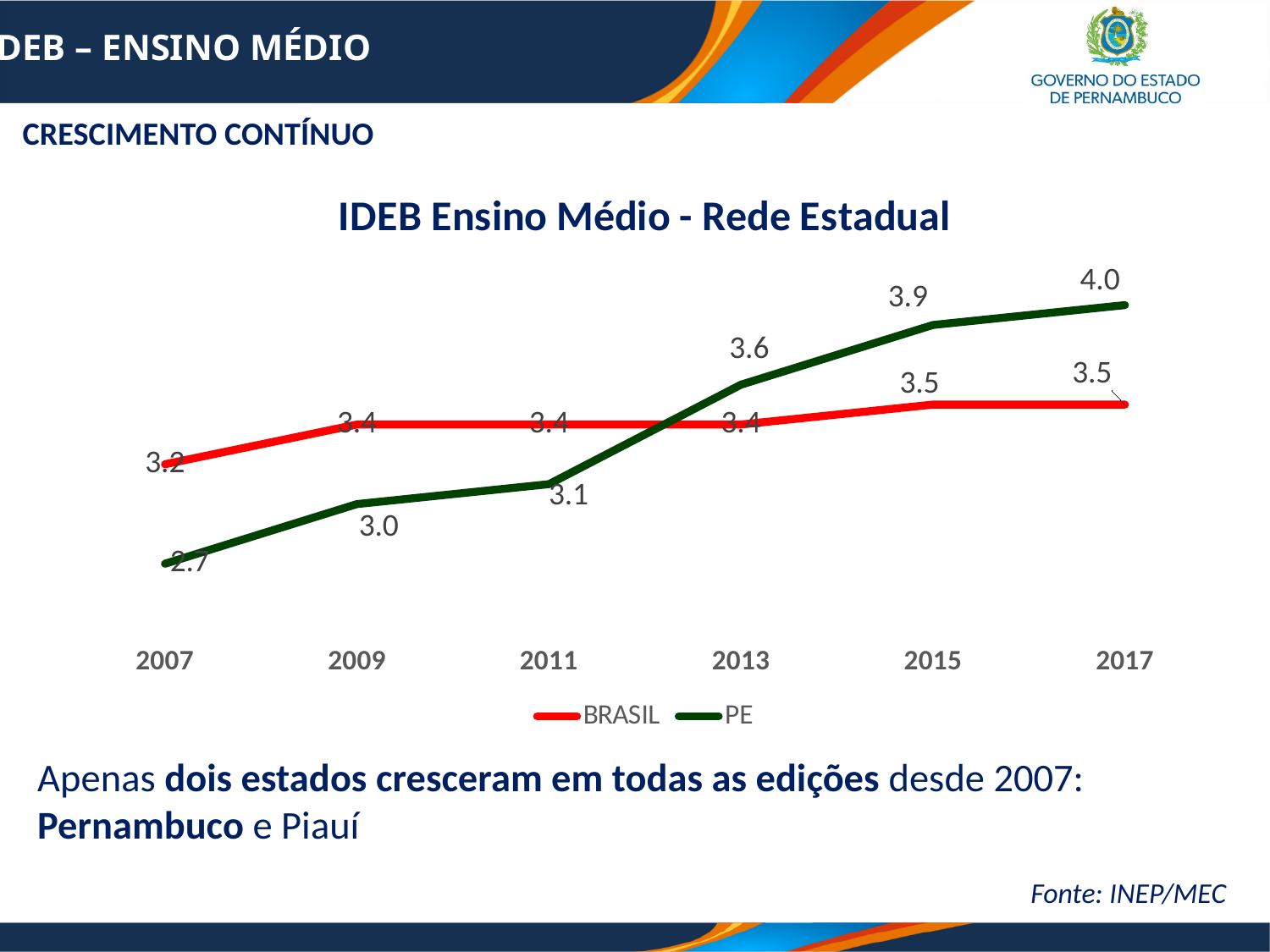
Which series has the larger value in 2015, BRASIL or PE? PE What is the value for BRASIL in 2007? 3.2 In which year is the PE series highest? 2017 Which series has the larger value in 2009, BRASIL or PE? BRASIL What kind of chart is shown? Line chart What is the value for BRASIL in 2015? 3.5 How many years are shown on the x axis? 6 In which year is the PE series lowest? 2007 How many series does the legend list? 2 What is the value for PE in 2011? 3.1 What is the value for PE in 2017? 4.0 What is the difference between PE and BRASIL in 2017? 0.5